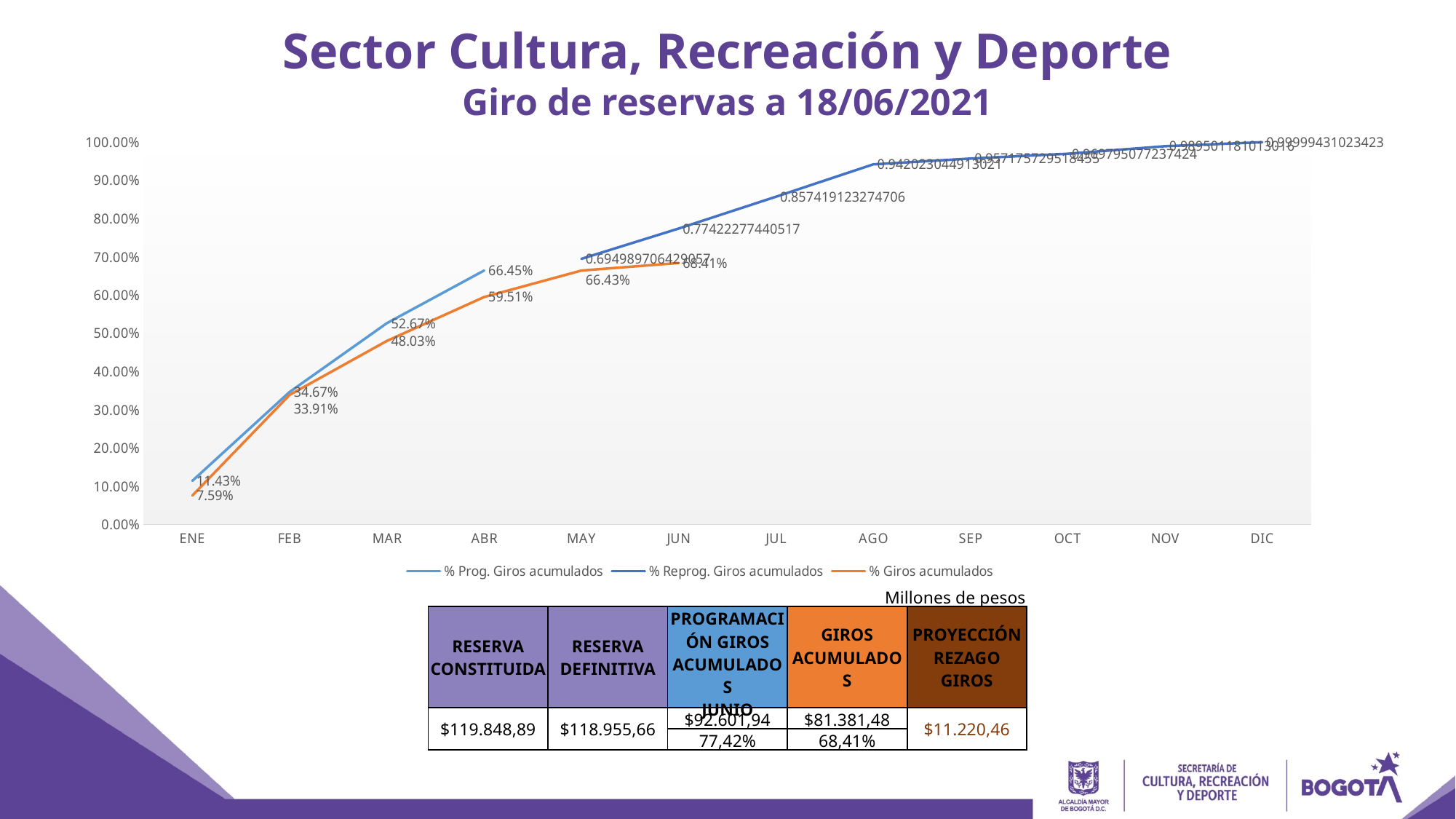
What kind of chart is shown on the slide? line chart Does the % Giros acumulados series rise or fall from ENE to JUN? rise How many months are shown on the x axis of the chart? 12 What is the value of % Giros acumulados for JUN? 68.41% What is the value of % Giros acumulados for ENE? 7.59% Is the value of % Reprog. Giros acumulados for DIC greater or less than 90.00%? greater Which month has the highest value for % Giros acumulados? JUN How many series does the chart legend list? 3 What is the value of % Reprog. Giros acumulados for JUL? 0.857419123274706 What is the value of % Prog. Giros acumulados for ABR? 66.45% In FEB, which is larger: % Prog. Giros acumulados or % Giros acumulados? % Prog. Giros acumulados What is the difference between % Prog. Giros acumulados and % Giros acumulados in MAR? 4.64 percentage points